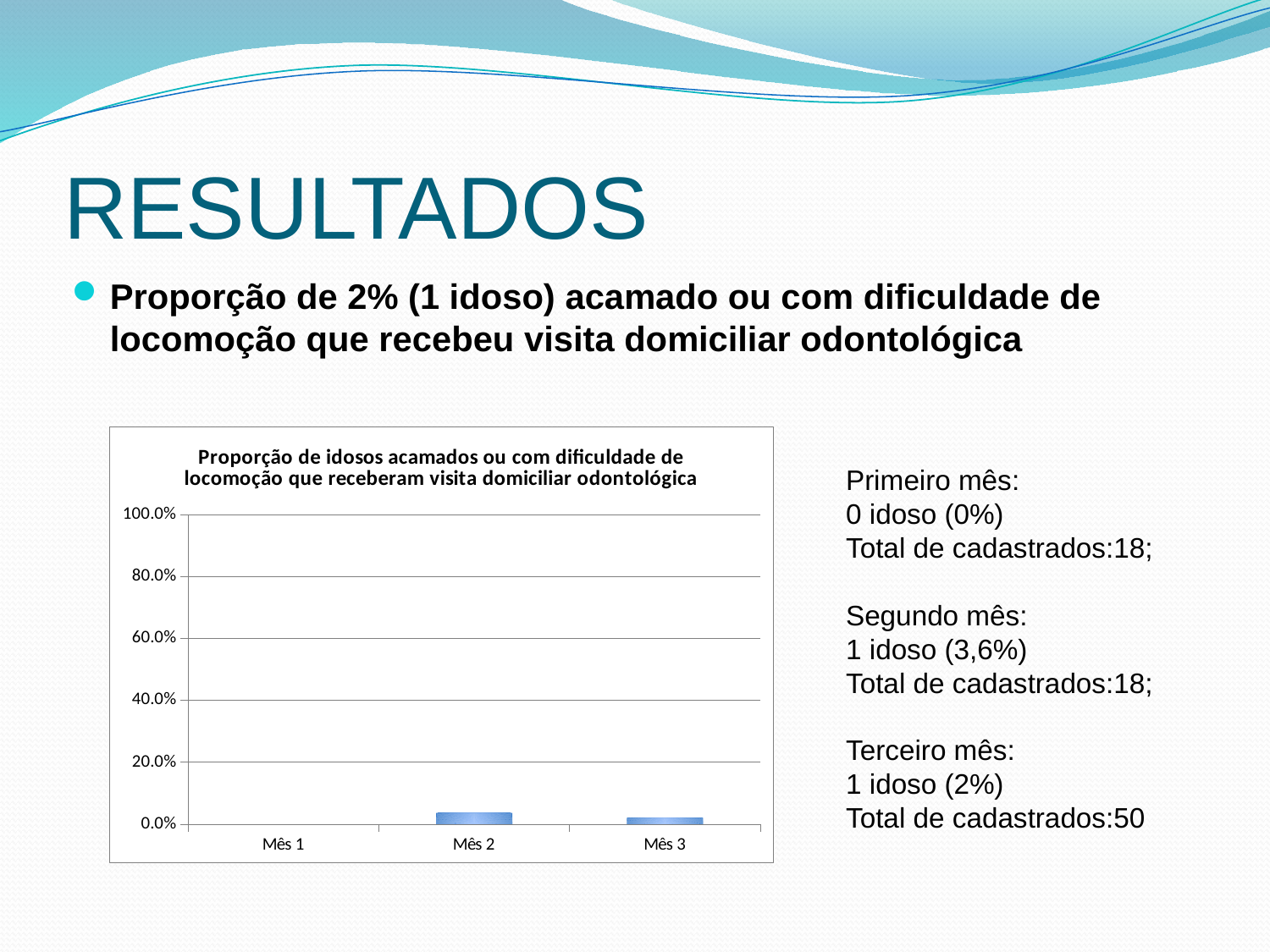
What is the value for Mês 1 in the chart? 0.0% Is the value for Mês 3 greater or less than 20.0%? less Which month has the highest value in the chart? Mês 2 What type of chart is shown on the slide? bar chart How many categories (months) are shown on the x axis of the chart? 3 What is the highest value shown on the y axis of the chart? 100.0% What is the title of the chart? Proporção de idosos acamados ou com dificuldade de locomoção que receberam visita domiciliar odontológica Is the value for Mês 2 greater or less than 20.0%? less Which is larger, the value for Mês 2 or the value for Mês 3? Mês 2 Which month has the lowest value in the chart? Mês 1